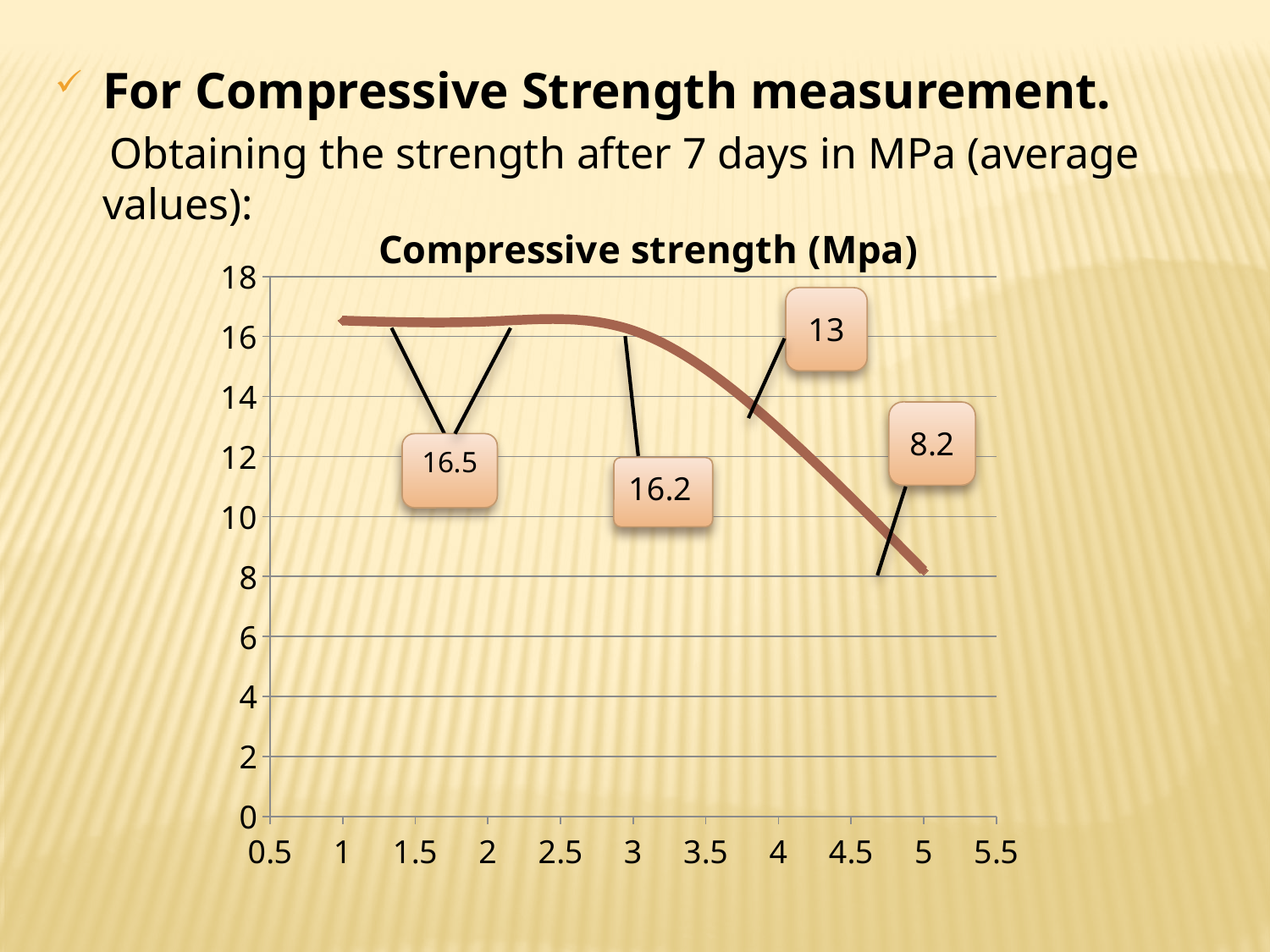
Does the compressive strength rise or fall as x increases from 3 to 5? fall What is the compressive strength value at x = 4? 13 What type of chart is shown on the slide? line chart What is the difference between the compressive strength at x = 3 and at x = 4? 3.2 What is the compressive strength value at x = 3? 16.2 What is the title of the chart? Compressive strength (Mpa) At which x value is the compressive strength lowest? 5 What is the difference between the compressive strength at x = 4 and at x = 5? 4.8 What is the compressive strength value at x = 5? 8.2 Is the compressive strength at x = 4 greater or less than 14? less What is the compressive strength value at x = 1? 16.5 Which is larger, the compressive strength at x = 3 or at x = 5? x = 3